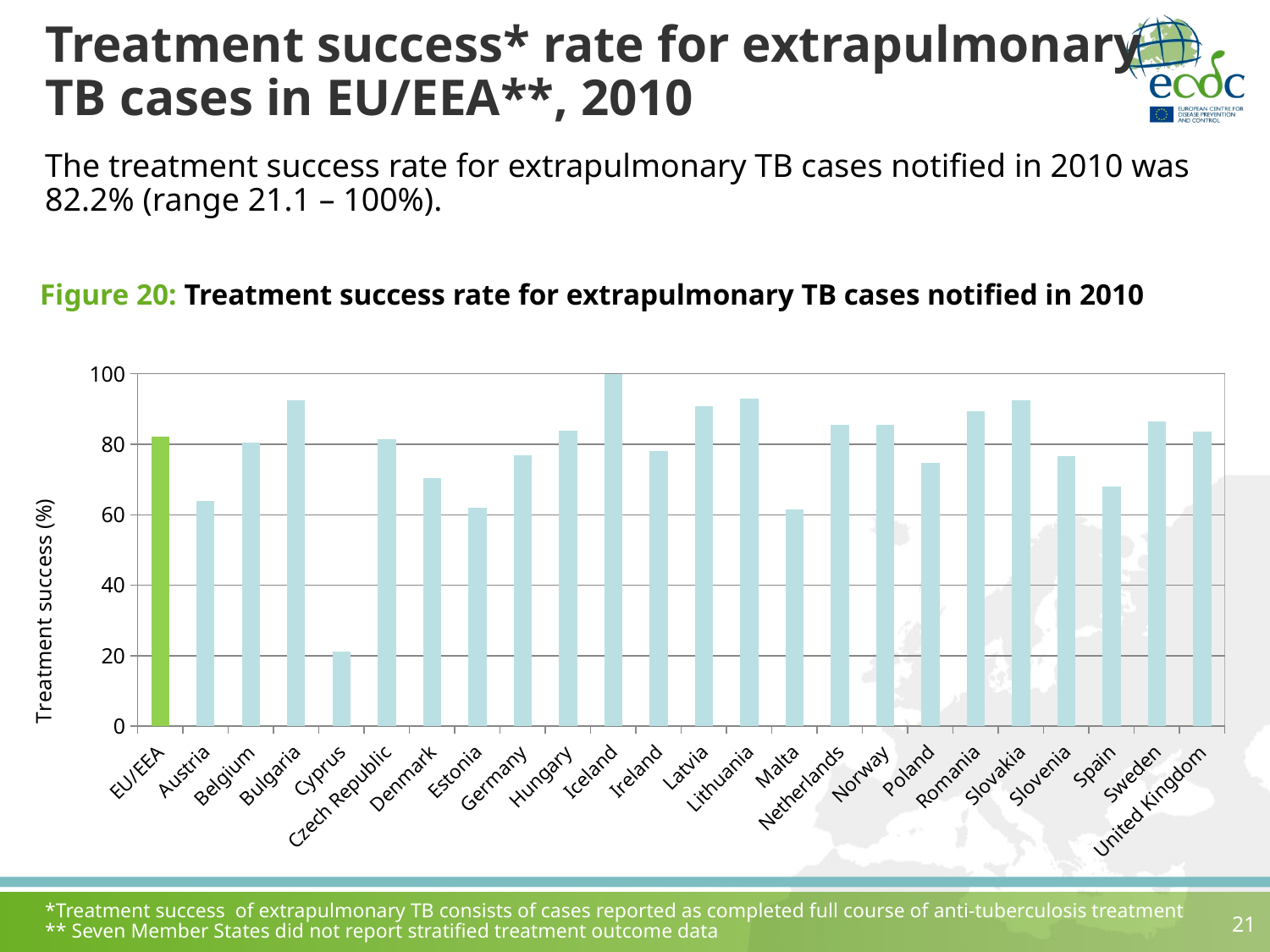
What type of chart is shown in Figure 20? bar chart Which country has the highest treatment success rate in Figure 20? Iceland What is the label of the y axis in Figure 20? Treatment success (%) Which country has the lowest treatment success rate in Figure 20? Cyprus Is the treatment success rate for Cyprus greater or less than 40? less Which has a higher treatment success rate, Bulgaria or Austria? Bulgaria How many bars (categories) are plotted in Figure 20? 24 Is the treatment success rate for Bulgaria greater or less than 80? greater Is the treatment success rate for Poland greater or less than 80? less What is the treatment success rate for Iceland in Figure 20? 100 What is the treatment success rate for EU/EEA shown on the slide? 82.2%